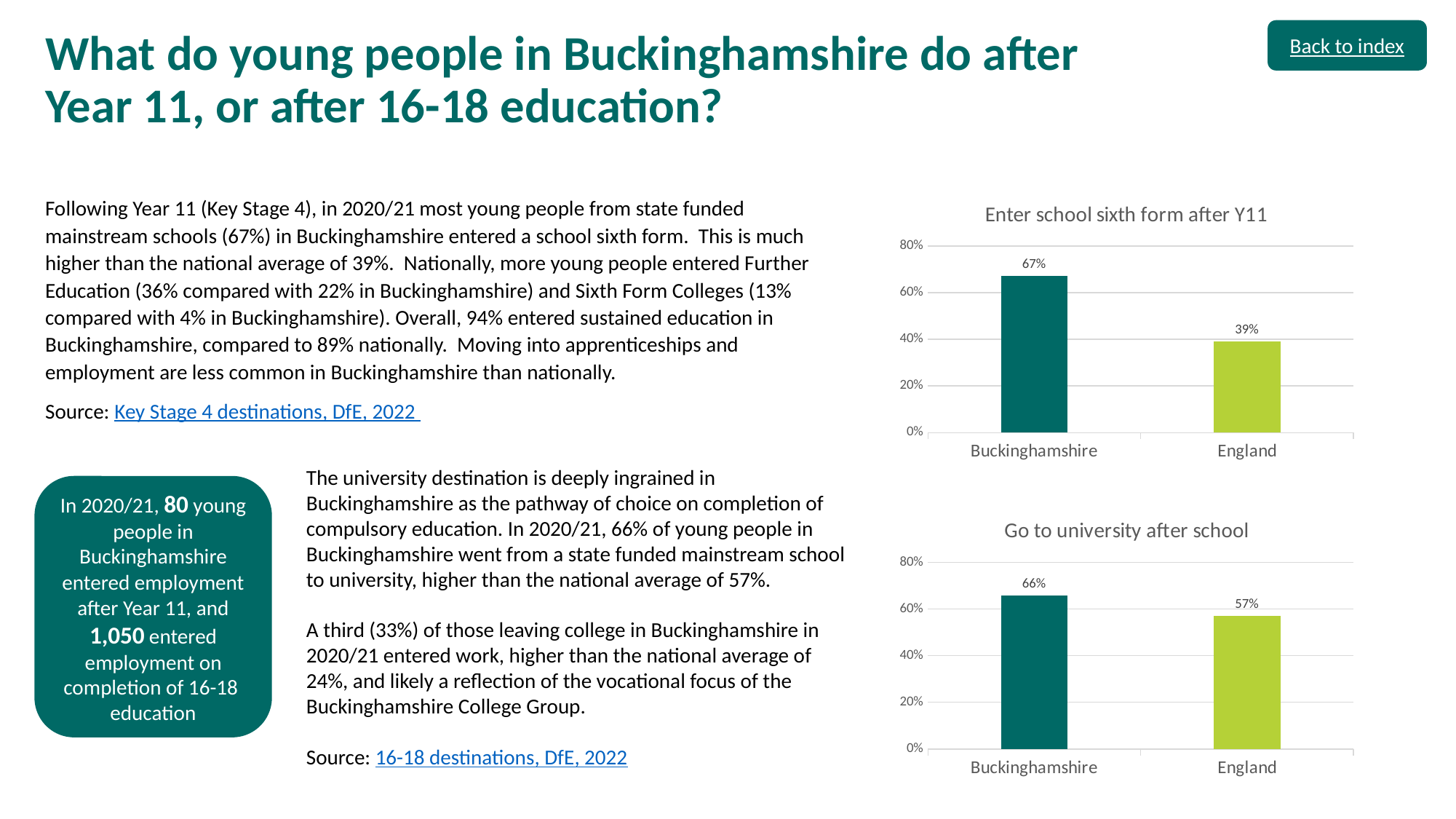
In the 'Go to university after school' chart, what is the difference between the Buckinghamshire and England values? 9% How many categories are shown in the 'Go to university after school' chart? 2 In the 'Enter school sixth form after Y11' chart, is the value for England greater or less than 40%? less In the 'Enter school sixth form after Y11' chart, what is the difference between the Buckinghamshire and England values? 28% In the 'Go to university after school' chart, is the value for Buckinghamshire or England larger? Buckinghamshire In the 'Go to university after school' chart, what is the value for England? 57% In the 'Enter school sixth form after Y11' chart, what is the value for Buckinghamshire? 67% In the 'Enter school sixth form after Y11' chart, which category has the highest value? Buckinghamshire In the 'Enter school sixth form after Y11' chart, what is the value for England? 39% In the 'Go to university after school' chart, what is the value for Buckinghamshire? 66% What type of chart is the 'Enter school sixth form after Y11' chart? Bar chart In the 'Go to university after school' chart, which category has the lowest value? England